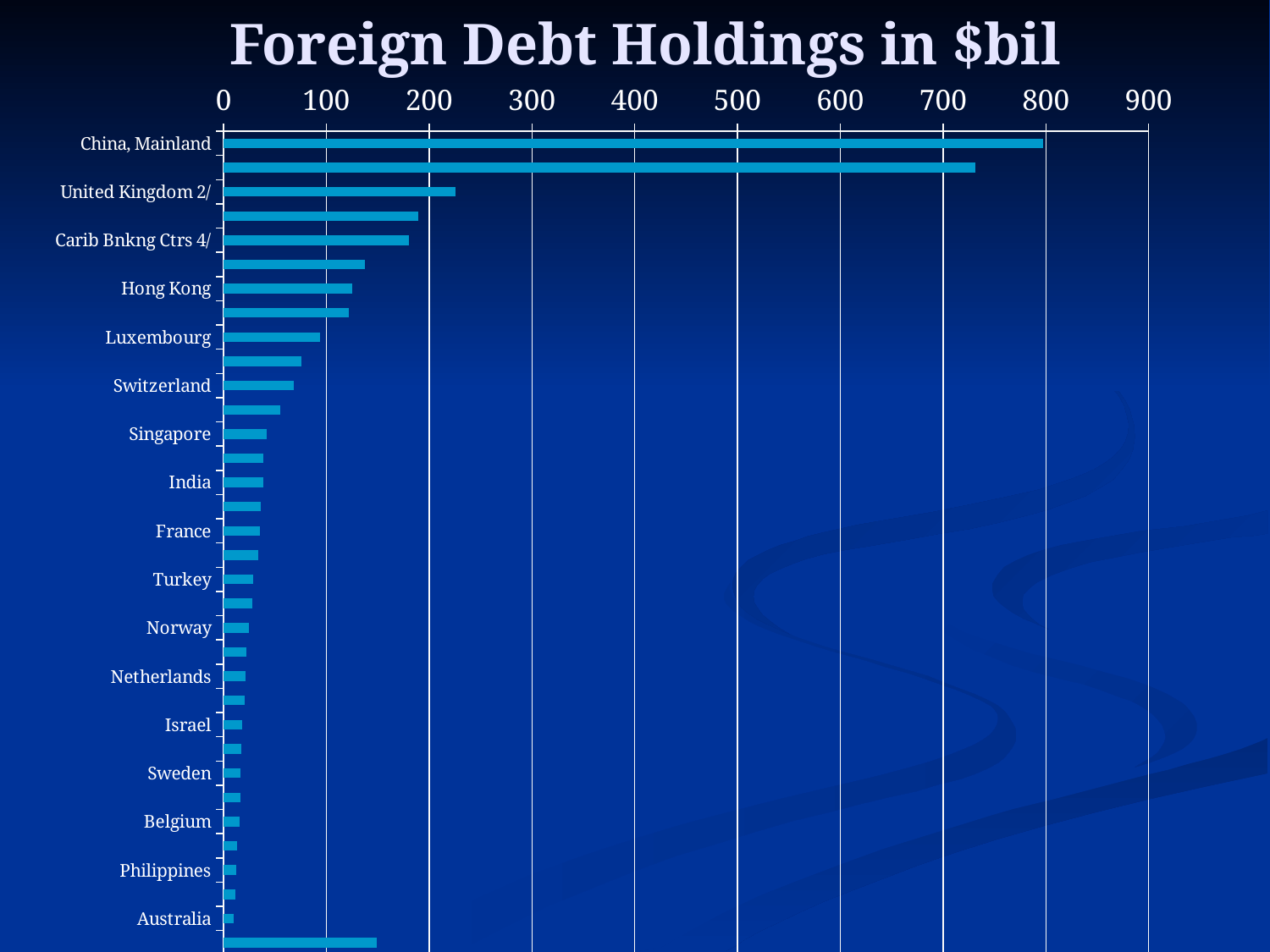
Is the value for China, Mainland greater or less than 700? greater Which has the larger value, Switzerland or Singapore? Switzerland Is the value for Switzerland greater or less than 100? less Is the value for Carib Bnkng Ctrs 4/ greater or less than 200? less What is the title of the chart? Foreign Debt Holdings in $bil Which labeled country has the shortest bar? Australia What kind of chart is shown on the slide? bar chart Which has the larger value, United Kingdom 2/ or Carib Bnkng Ctrs 4/? United Kingdom 2/ Which labeled category has the longest bar? China, Mainland What is the highest value shown on the horizontal axis? 900